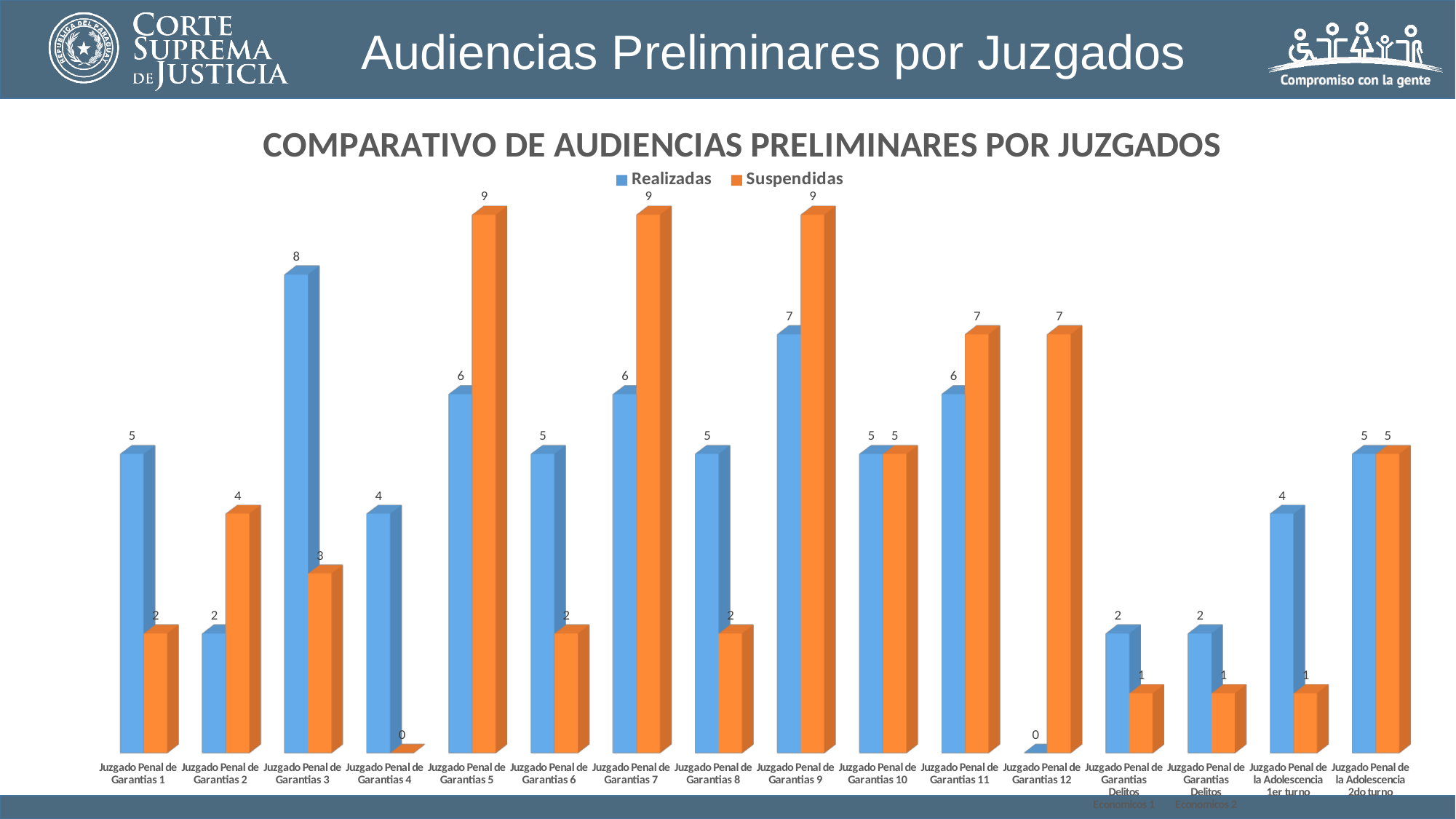
Which colour represents the Suspendidas series? Orange How many juzgados (categories) are shown on the x axis? 16 Which juzgado has the lowest Suspendidas value? Juzgado Penal de Garantias 4 What kind of chart is shown on the slide? Bar chart What is the Suspendidas value for Juzgado Penal de Garantias 12? 7 How many Realizadas audiencias are shown for Juzgado Penal de Garantias 3? 8 What is the difference between Suspendidas and Realizadas for Juzgado Penal de Garantias 9? 2 Which juzgado has the highest Realizadas value? Juzgado Penal de Garantias 3 Which juzgado has the lowest Realizadas value? Juzgado Penal de Garantias 12 For Juzgado Penal de Garantias 2, which is larger: Realizadas or Suspendidas? Suspendidas What is the Suspendidas value for Juzgado Penal de Garantias 5? 9 How many series does the legend list? 2